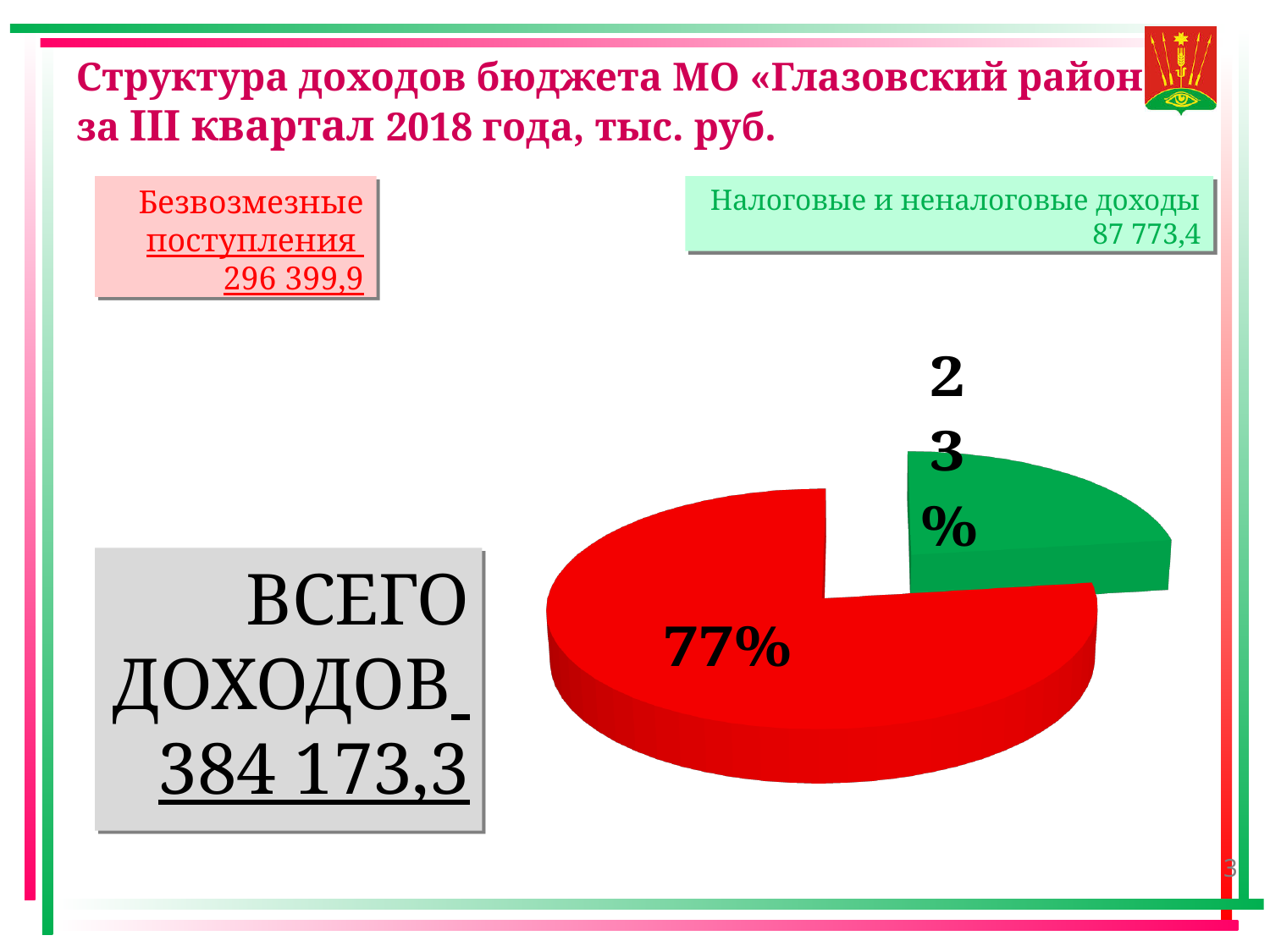
What kind of chart is shown on the slide? pie chart What is the difference in percentage points between the red slice and the green slice of the pie chart? 54 percentage points What total is shown for «ВСЕГО ДОХОДОВ» on the slide? 384 173,3 Is the red slice or the green slice of the pie chart larger? the red slice Which slice of the pie chart is the largest? the red slice (77%) What value is shown for «Безвозмездные поступления» on the slide? 296 399,9 Is the share of the green slice greater or less than 25%? less How many slices does the pie chart have? 2 What value is shown for «Налоговые и неналоговые доходы» on the slide? 87 773,4 What percentage is shown on the red slice of the pie chart? 77% Which slice of the pie chart is the smallest? the green slice (23%) What percentage is shown on the green slice of the pie chart? 23%